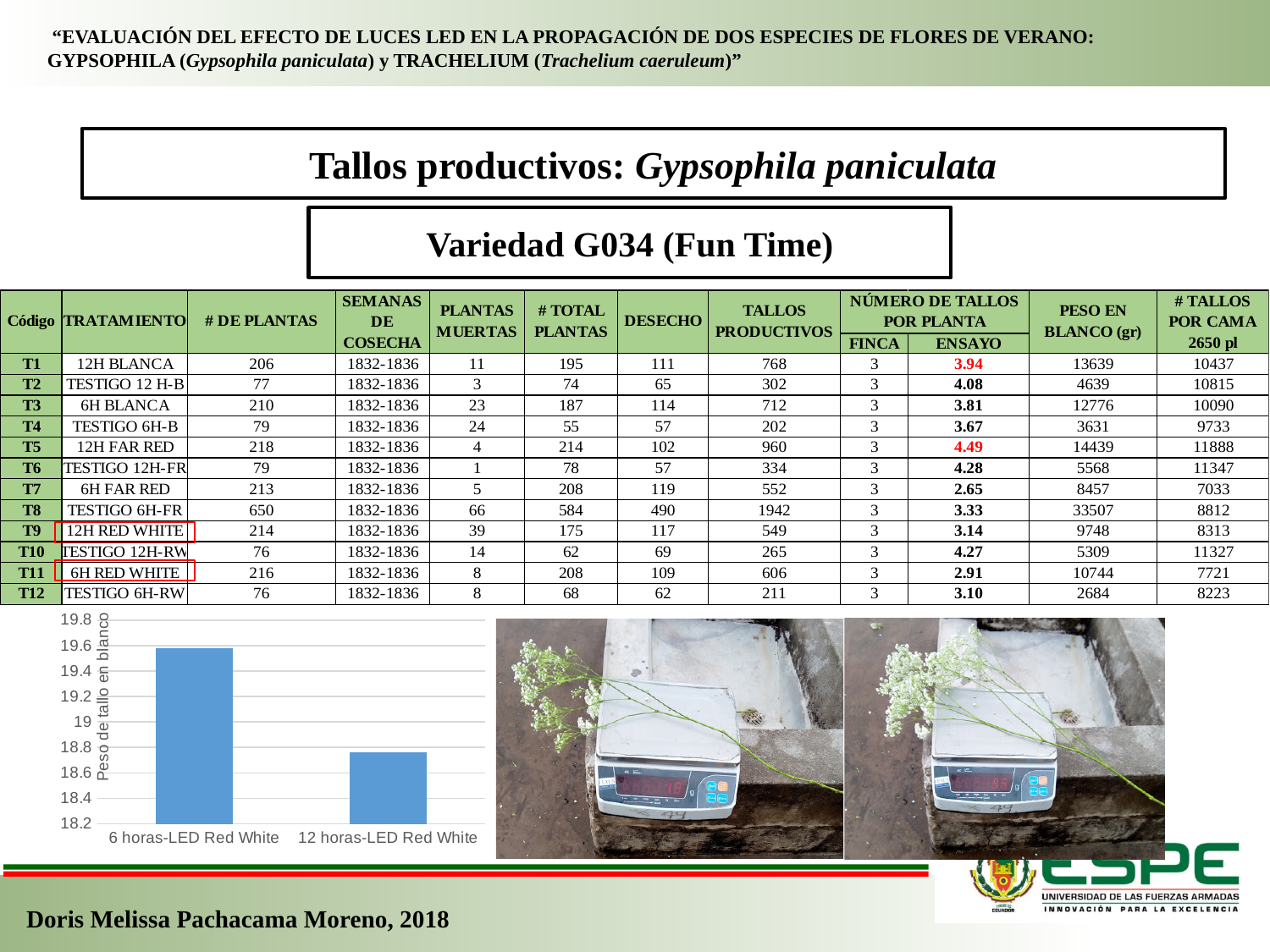
What is the lowest value shown on the vertical axis of the chart? 18.2 What kind of chart is shown at the bottom left of the slide? bar chart How many bars does the chart show? 2 Is the value for 12 horas-LED Red White greater or less than 19? less What is the title of the vertical axis of the chart? Peso de tallo en blanco Is the value for 6 horas-LED Red White greater or less than 19.4? greater Which is larger in the chart, the value for 6 horas-LED Red White or for 12 horas-LED Red White? 6 horas-LED Red White Which category has the lowest bar in the chart? 12 horas-LED Red White Is the value for 6 horas-LED Red White greater or less than 19.8? less Which category has the highest bar in the chart? 6 horas-LED Red White Do the values rise or fall from the first bar to the second bar along the x axis? fall